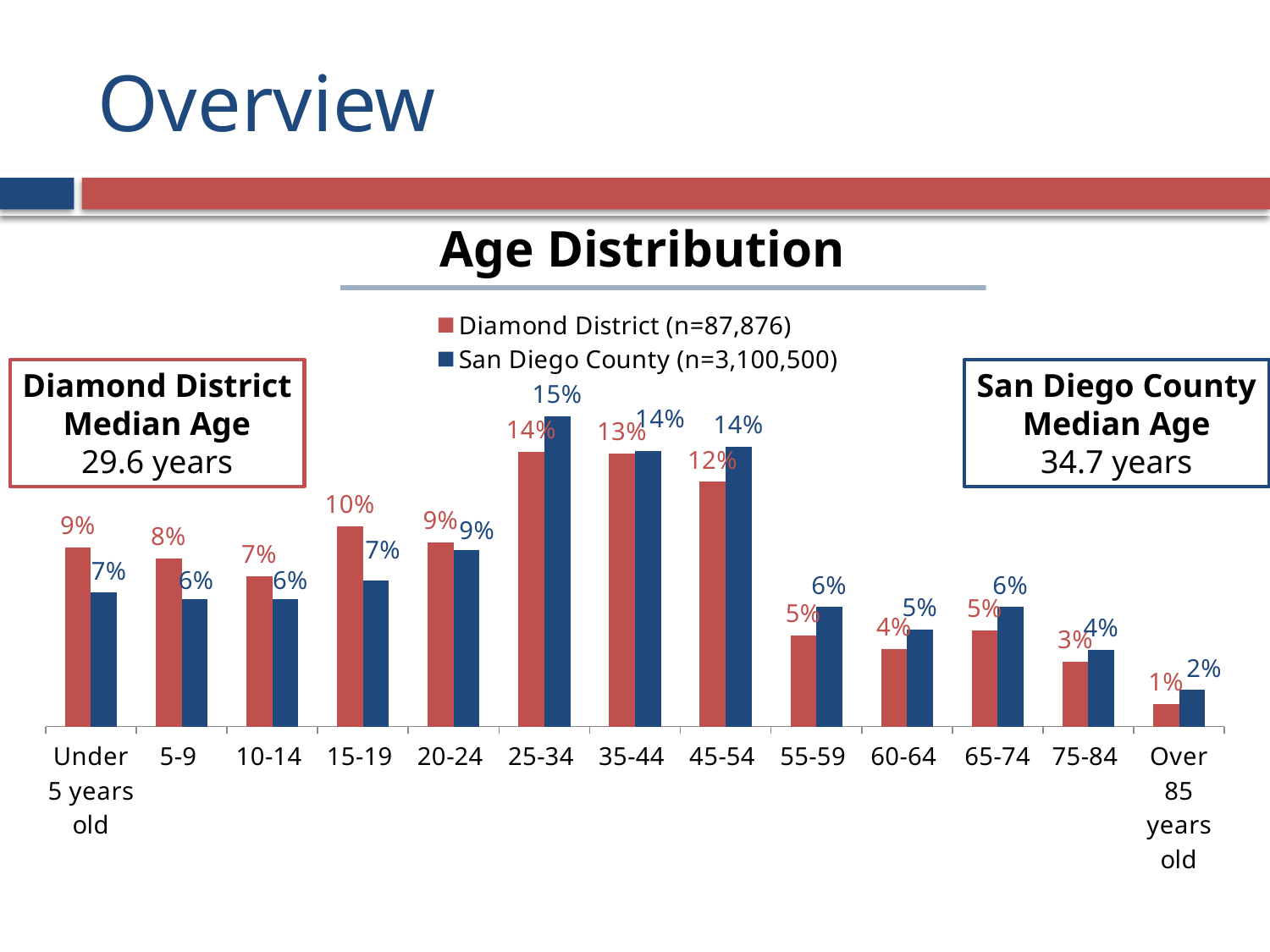
How many age groups are shown on the x axis? 13 For the 45-54 age group, which is larger: the Diamond District value or the San Diego County value? San Diego County What percentage of San Diego County's population is in the 25-34 age group? 15% Which age group has the lowest share for San Diego County? Over 85 years old What is the Diamond District value for the 45-54 age group? 12% What kind of chart is shown on the slide? Bar chart For the Under 5 years old group, which is larger: the Diamond District value or the San Diego County value? Diamond District What is the difference between the Diamond District and San Diego County values for the 15-19 age group? 3% How many series does the legend list? 2 What percentage of the Diamond District population is in the 15-19 age group? 10% What is the sample size (n) given in the legend for the Diamond District? 87,876 Which age group has the highest share for the Diamond District? 25-34